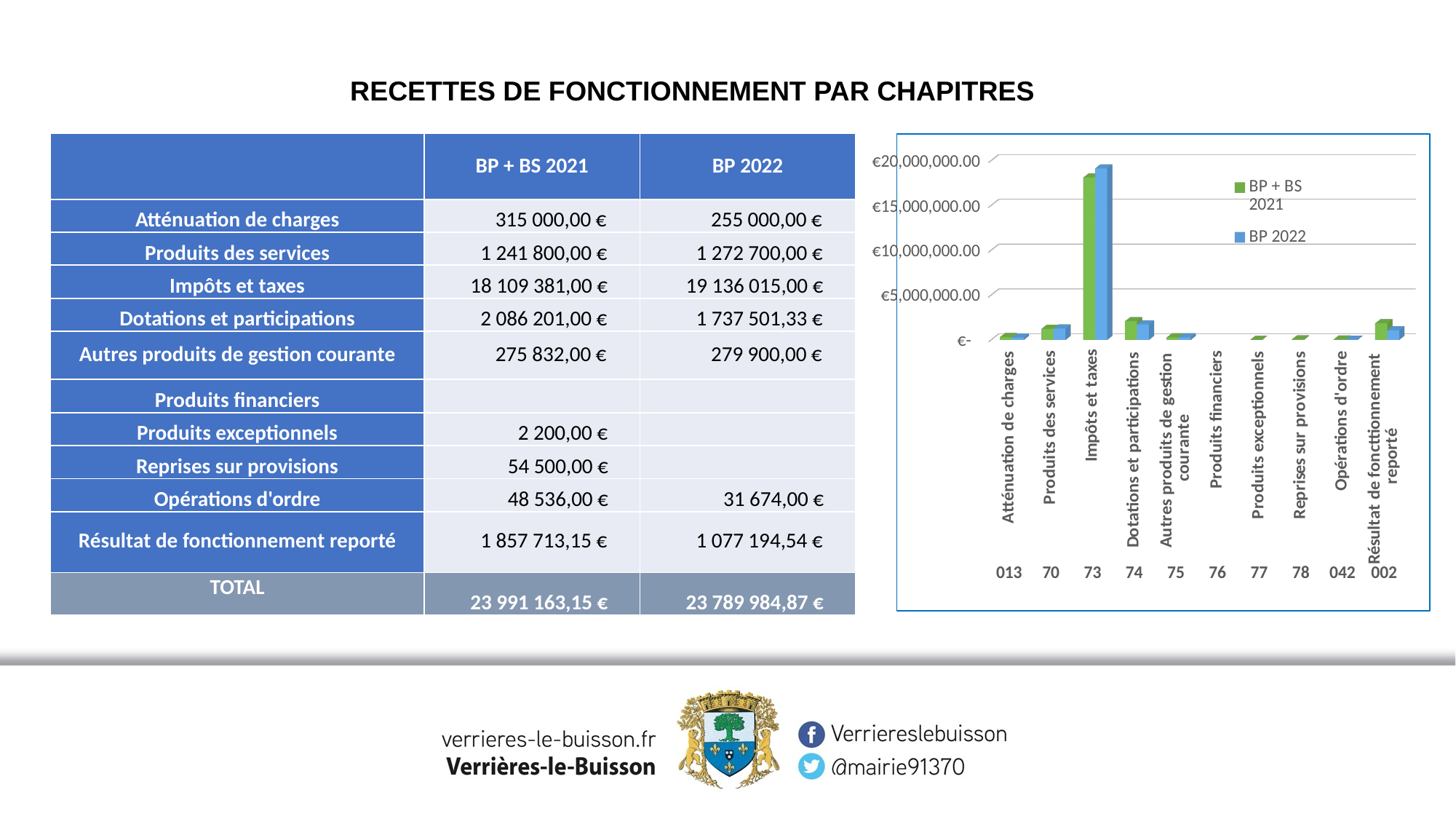
What is the difference between the BP + BS 2021 and BP 2022 values for Atténuation de charges? 60 000,00 € What kind of chart is shown on the slide? bar chart How many categories are shown on the x axis of the chart? 10 What is the total of the BP 2022 column? 23 789 984,87 € Which is larger for Atténuation de charges: BP + BS 2021 or BP 2022? BP + BS 2021 Which colour represents the BP 2022 series in the chart? blue Is the BP 2022 value for Impôts et taxes greater or less than €15,000,000.00? greater What is the BP 2022 value for Impôts et taxes? 19 136 015,00 € What is the BP + BS 2021 value for Résultat de fonctionnement reporté? 1 857 713,15 € Is the BP + BS 2021 value for Dotations et participations greater or less than €5,000,000.00? less Which category has the highest bars in the chart? Impôts et taxes How many series does the chart legend list? 2